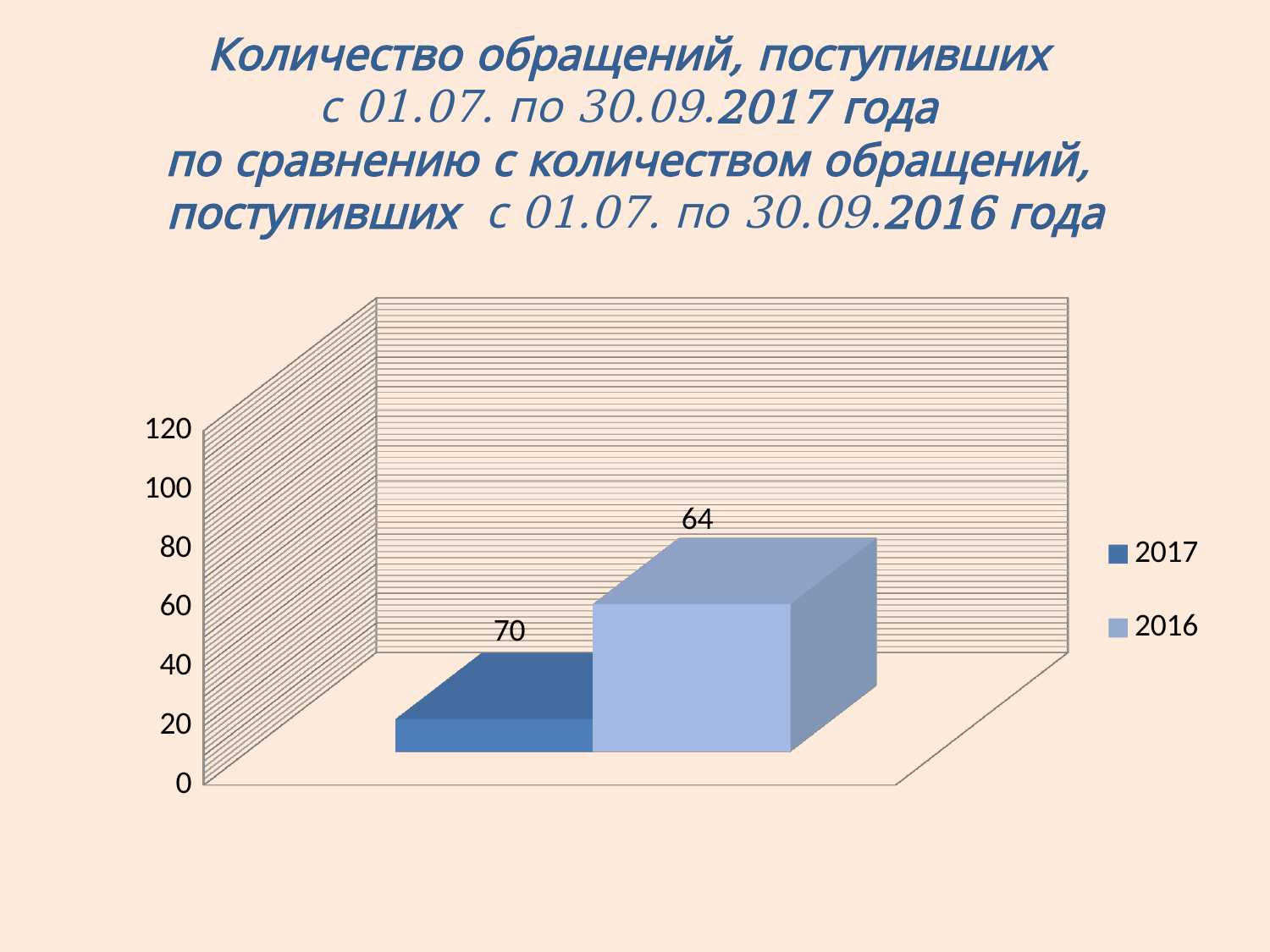
What is the value for 2017? 70 What is the value for 2016? 64 How many bars are plotted on the chart? 2 What kind of chart is shown on the slide? bar chart What is the difference between the value for 2017 and the value for 2016? 6 What is the highest value shown on the vertical axis? 120 How many series does the legend list? 2 Is the value for 2016 greater or less than 80? less